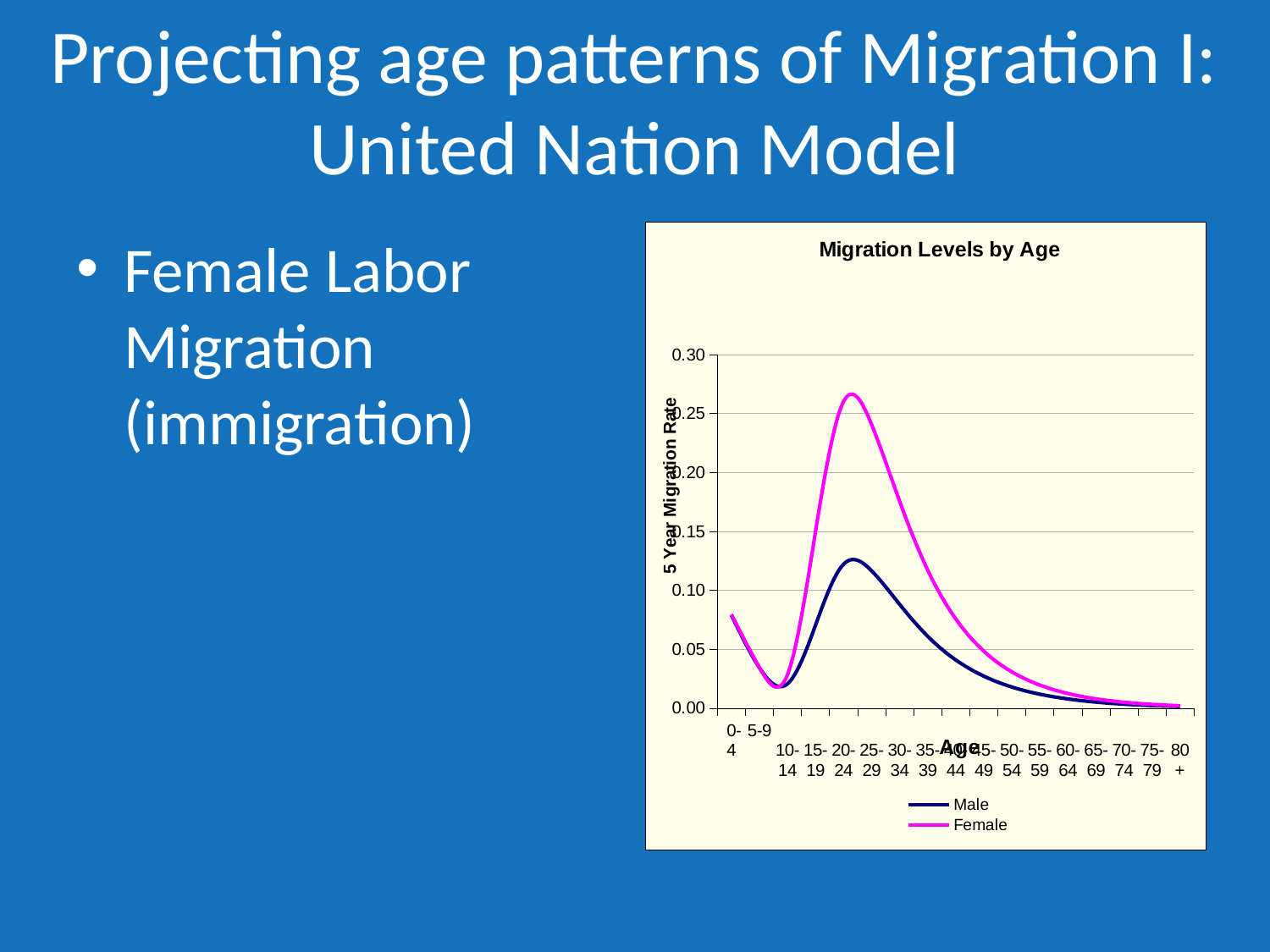
Is the peak value of the Female series greater or less than 0.25? greater Is the value for the Female series at age 80+ greater or less than 0.05? less Which series reaches the higher peak value, Male or Female? Female Is the value for the Male series at age 0-4 greater or less than 0.05? greater What is the label of the y axis of the chart? 5 Year Migration Rate How many age groups are shown along the x axis of the chart? 17 How many series does the chart's legend list? 2 In which age group does the Female series reach its highest value? 20-24 What type of chart is shown on the slide? Line chart What is the title of the chart? Migration Levels by Age Do the values of the Female series rise or fall along the x axis from age 25-29 to age 80+? fall